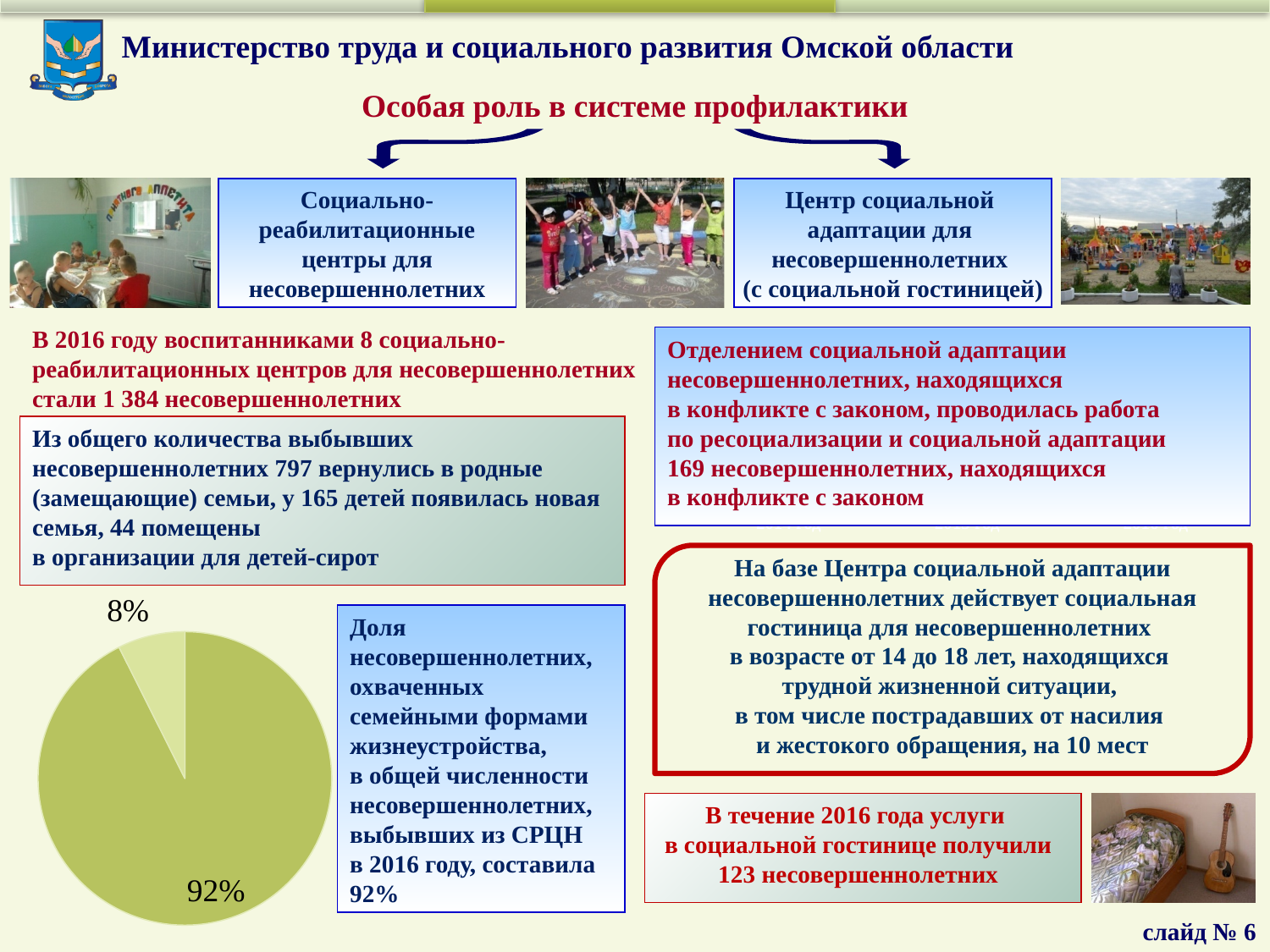
By how many percentage points does the larger slice of the pie chart exceed the smaller slice? 84 Which slice of the pie chart is larger, the one labelled 92% or the one labelled 8%? 92% What kind of chart is shown in the lower-left part of the slide? pie chart What is the value of the smallest slice of the pie chart? 8% What colour is the larger slice of the pie chart? olive green What is the value of the largest slice of the pie chart? 92% How many slices does the pie chart have? 2 Is the smaller slice of the pie chart greater or less than 10%? less According to the slide, what share of minors who left the SRCN in 2016 were covered by family forms of living arrangement? 92% Is the larger slice of the pie chart greater or less than 90%? greater Does the pie chart have a legend? No